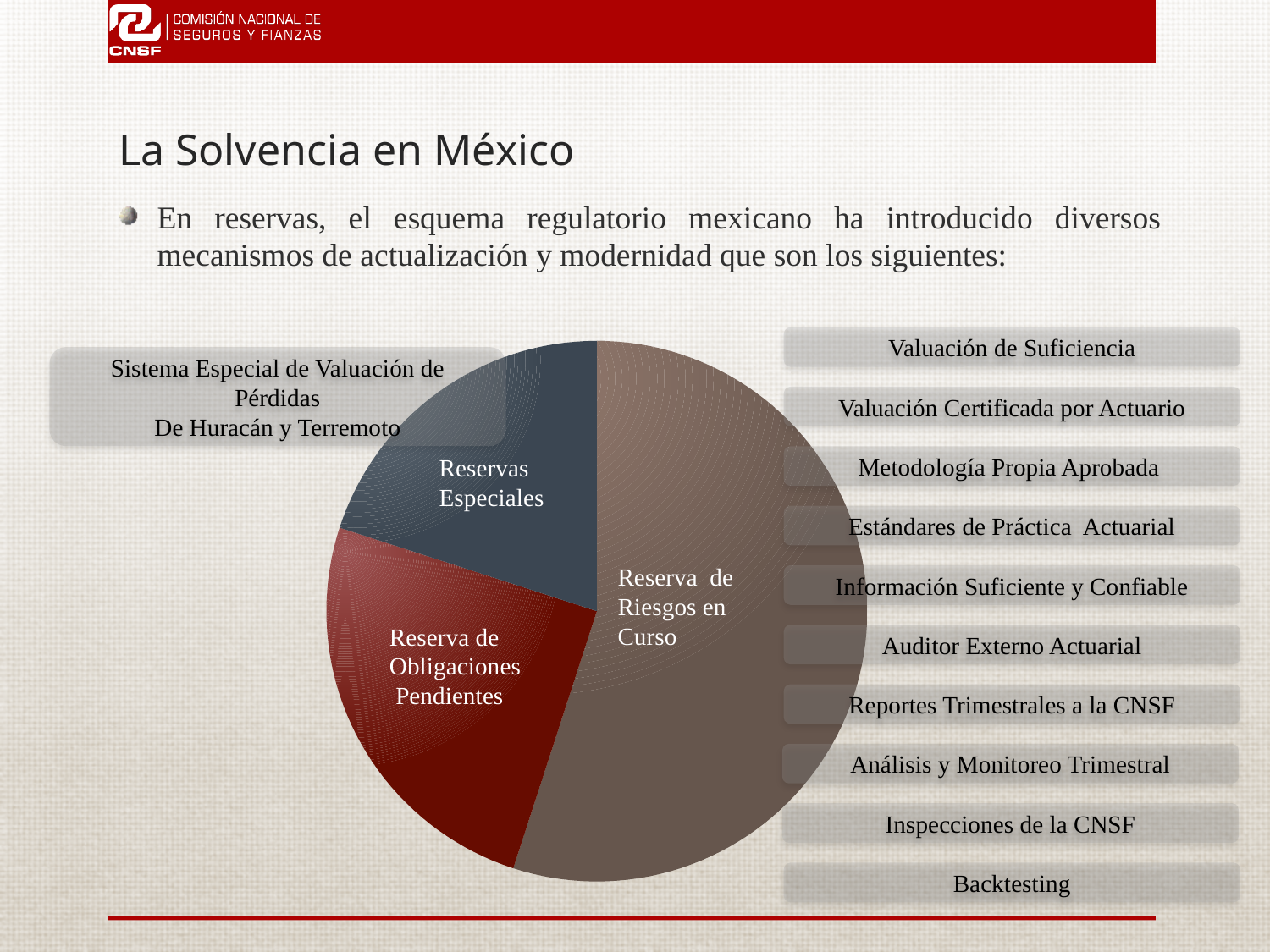
What colour is the Reserva de Obligaciones Pendientes slice of the pie chart? red Which slice of the pie chart is the largest? Reserva de Riesgos en Curso Which slice of the pie chart is the smallest? Reservas Especiales What kind of chart is shown on the slide? pie chart Which slice is larger, Reserva de Obligaciones Pendientes or Reservas Especiales? Reserva de Obligaciones Pendientes How many slices does the pie chart have? 3 Which slice is larger, Reserva de Riesgos en Curso or Reserva de Obligaciones Pendientes? Reserva de Riesgos en Curso Which slice of the pie chart is coloured brown? Reserva de Riesgos en Curso Is the share of the pie for Reserva de Riesgos en Curso greater or less than half? greater